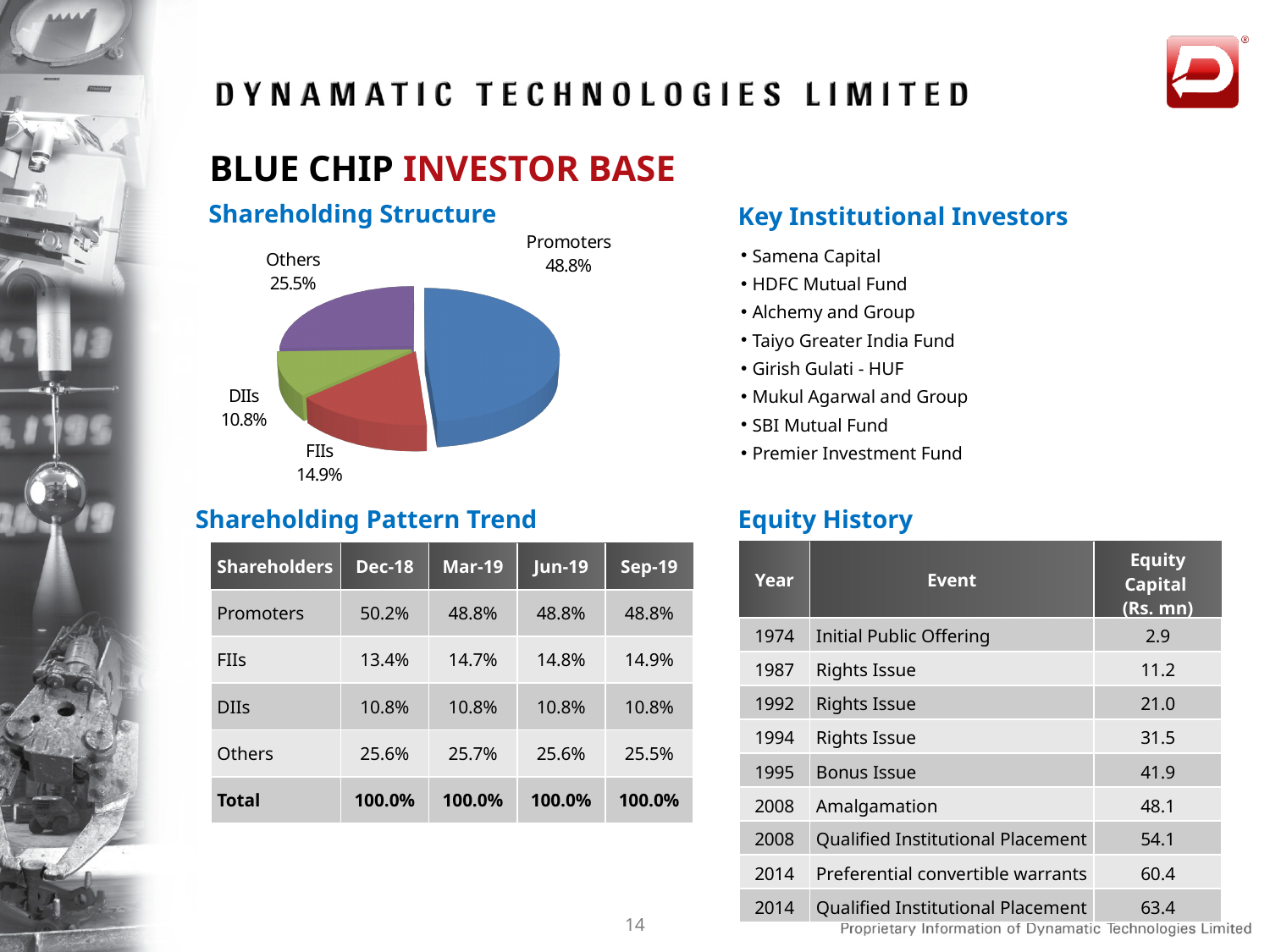
In the Shareholding Structure pie chart, what share do Promoters hold? 48.8% What kind of chart is the Shareholding Structure chart? Pie chart In the Shareholding Structure pie chart, which is larger: the FIIs slice or the Others slice? Others In the Shareholding Structure pie chart, what is the difference between the FIIs share and the DIIs share? 4.1% Which category has the smallest slice in the Shareholding Structure pie chart? DIIs In the Shareholding Structure pie chart, what share is labelled Others? 25.5% Which category has the largest slice in the Shareholding Structure pie chart? Promoters In the Shareholding Structure pie chart, what is the difference between the Promoters share and the Others share? 23.3% In the Shareholding Structure pie chart, what share do FIIs hold? 14.9% How many slices does the Shareholding Structure pie chart have? 4 What colour is the Promoters slice in the Shareholding Structure pie chart? Blue In the Shareholding Structure pie chart, what share do DIIs hold? 10.8%